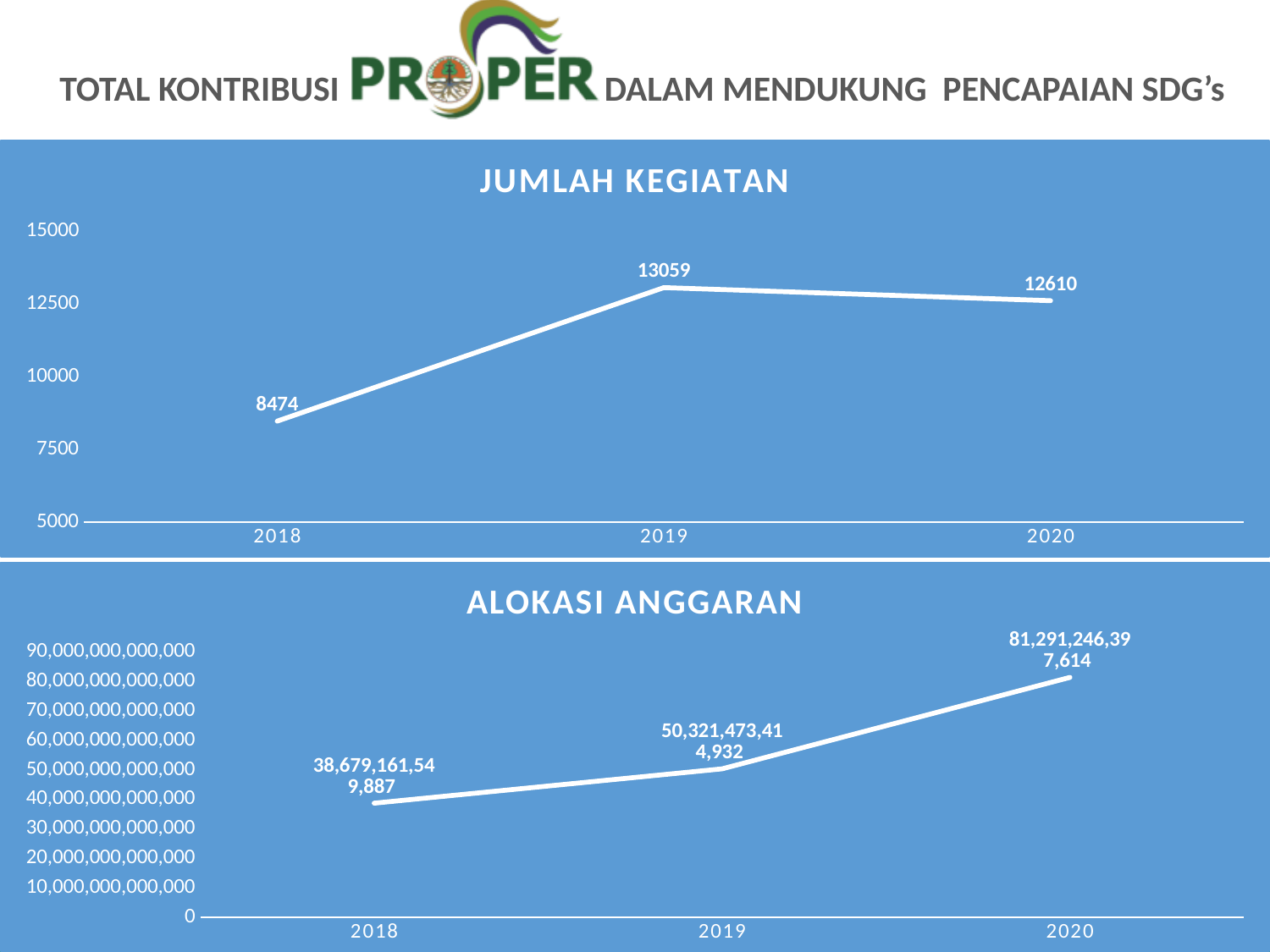
In the JUMLAH KEGIATAN chart, is the value for 2020 greater or less than 12500? greater In the JUMLAH KEGIATAN chart, what is the difference between the 2019 and 2020 values? 449 In the ALOKASI ANGGARAN chart, do the values rise or fall from 2018 to 2020? rise In the JUMLAH KEGIATAN chart, what is the difference between the 2019 and 2018 values? 4585 What kind of chart is the ALOKASI ANGGARAN chart? line chart In the JUMLAH KEGIATAN chart, which year has the lowest value? 2018 In the ALOKASI ANGGARAN chart, which is larger, the value for 2019 or the value for 2020? 2020 In the JUMLAH KEGIATAN chart, what is the value for 2018? 8474 In the JUMLAH KEGIATAN chart, which year has the highest value? 2019 In the ALOKASI ANGGARAN chart, what is the value for 2018? 38,679,161,549,887 In the ALOKASI ANGGARAN chart, what is the value for 2020? 81,291,246,397,614 In the JUMLAH KEGIATAN chart, what is the value for 2019? 13059